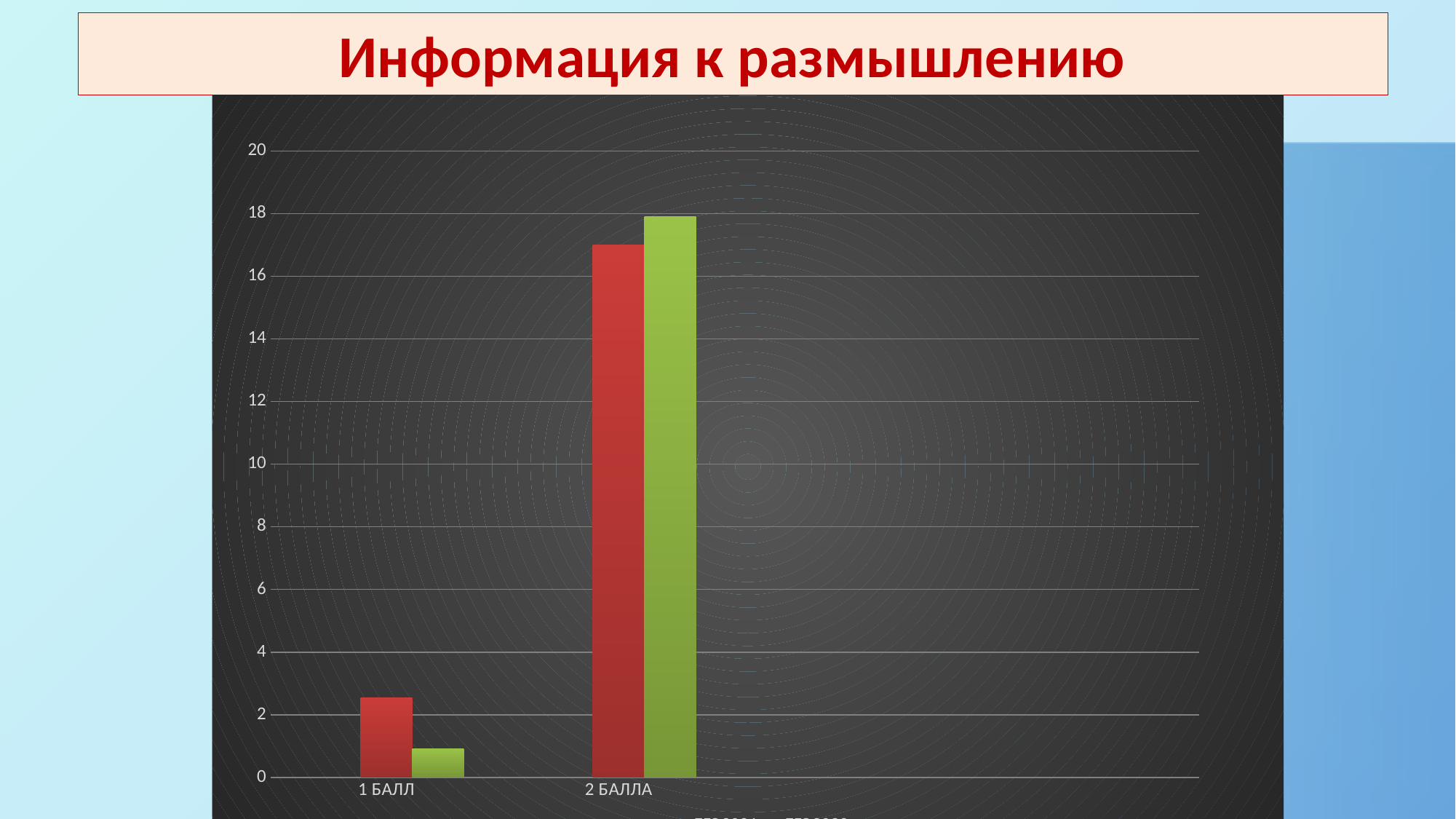
Is the value of the red bar for 1 БАЛЛ greater or less than 4? less Is the value of the green bar for 1 БАЛЛ greater or less than 2? less Is the value of the red bar for 2 БАЛЛА greater or less than 16? greater What is the title shown above the chart on the slide? Информация к размышлению Which category has the tallest bars in the chart? 2 БАЛЛА Which category has the shortest bars in the chart? 1 БАЛЛ What kind of chart is shown on the slide? bar chart For the category 1 БАЛЛ, which bar is taller, the red one or the green one? the red one For the category 2 БАЛЛА, which bar is taller, the red one or the green one? the green one How many categories are shown on the x axis of the chart? 2